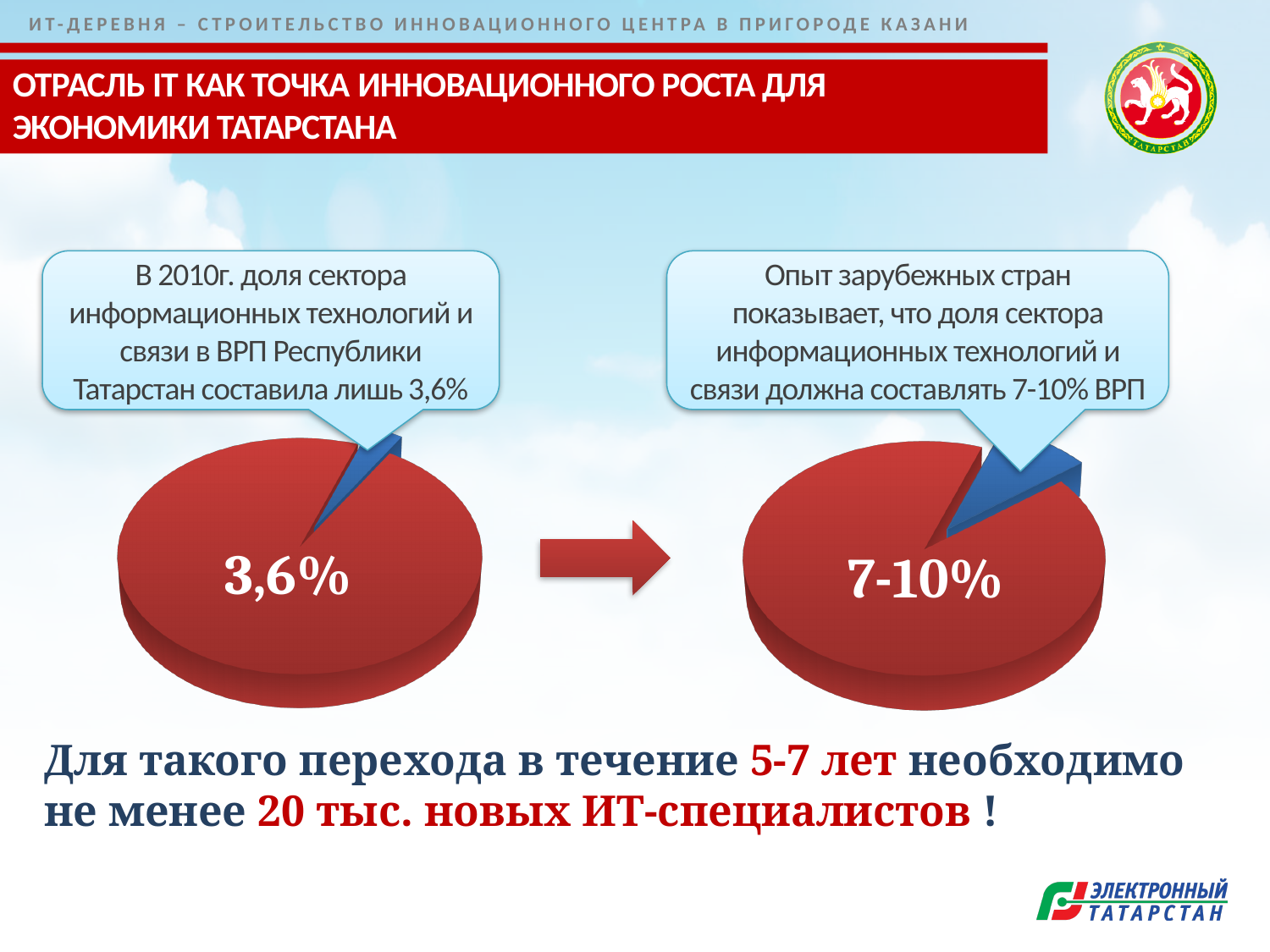
What colour is the large slice in both pie charts? red What kind of chart is shown on the left side of the slide? pie chart How many slices does the right pie chart have? 2 What kind of chart is shown on the right side of the slide? pie chart Which pie chart has the larger blue slice, the left one or the right one? the right one How many pie charts are on the slide? 2 According to the callout above the left pie chart, which year does the 3,6% share refer to? 2010 In the left pie chart, what share does the blue slice represent? 3,6% In the right pie chart, what share does the blue slice represent? 7-10% How many slices does the left pie chart have? 2 In the left pie chart, is the blue slice's share greater or less than 5%? less